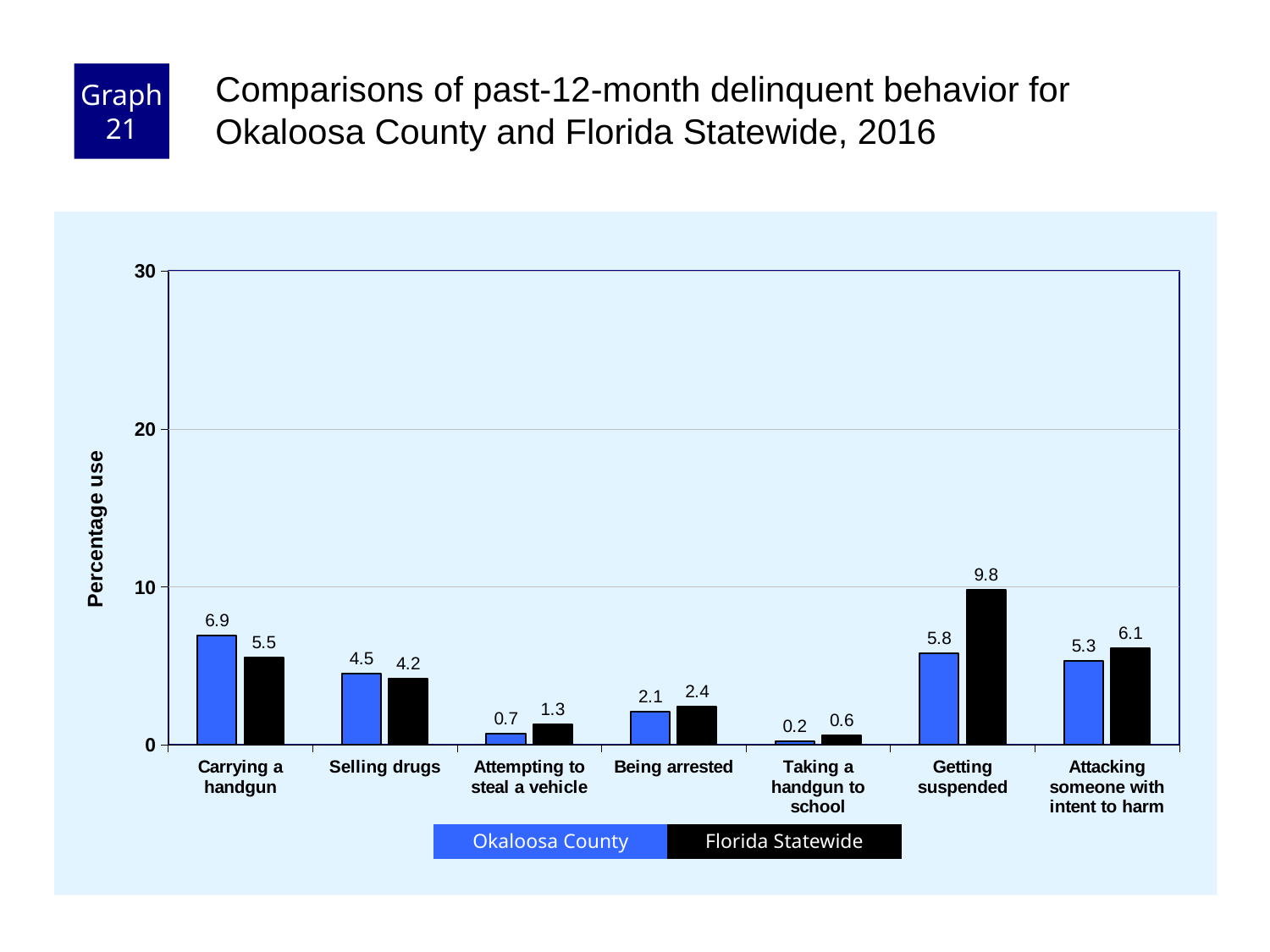
How many series does the legend list? 2 Which category has the highest Florida Statewide value? Getting suspended What is the Florida Statewide value for Carrying a handgun? 5.5 What is the difference between the Florida Statewide and Okaloosa County values for Getting suspended? 4.0 Which category has the lowest Okaloosa County value? Taking a handgun to school What is the difference between the Okaloosa County and Florida Statewide values for Carrying a handgun? 1.4 What is the Okaloosa County value for Taking a handgun to school? 0.2 How many categories are shown on the x axis? 7 Is the Florida Statewide value for Getting suspended greater or less than 10? less What kind of chart is shown on the slide? bar chart What is the Okaloosa County value for Getting suspended? 5.8 For Attacking someone with intent to harm, which is larger: Okaloosa County or Florida Statewide? Florida Statewide